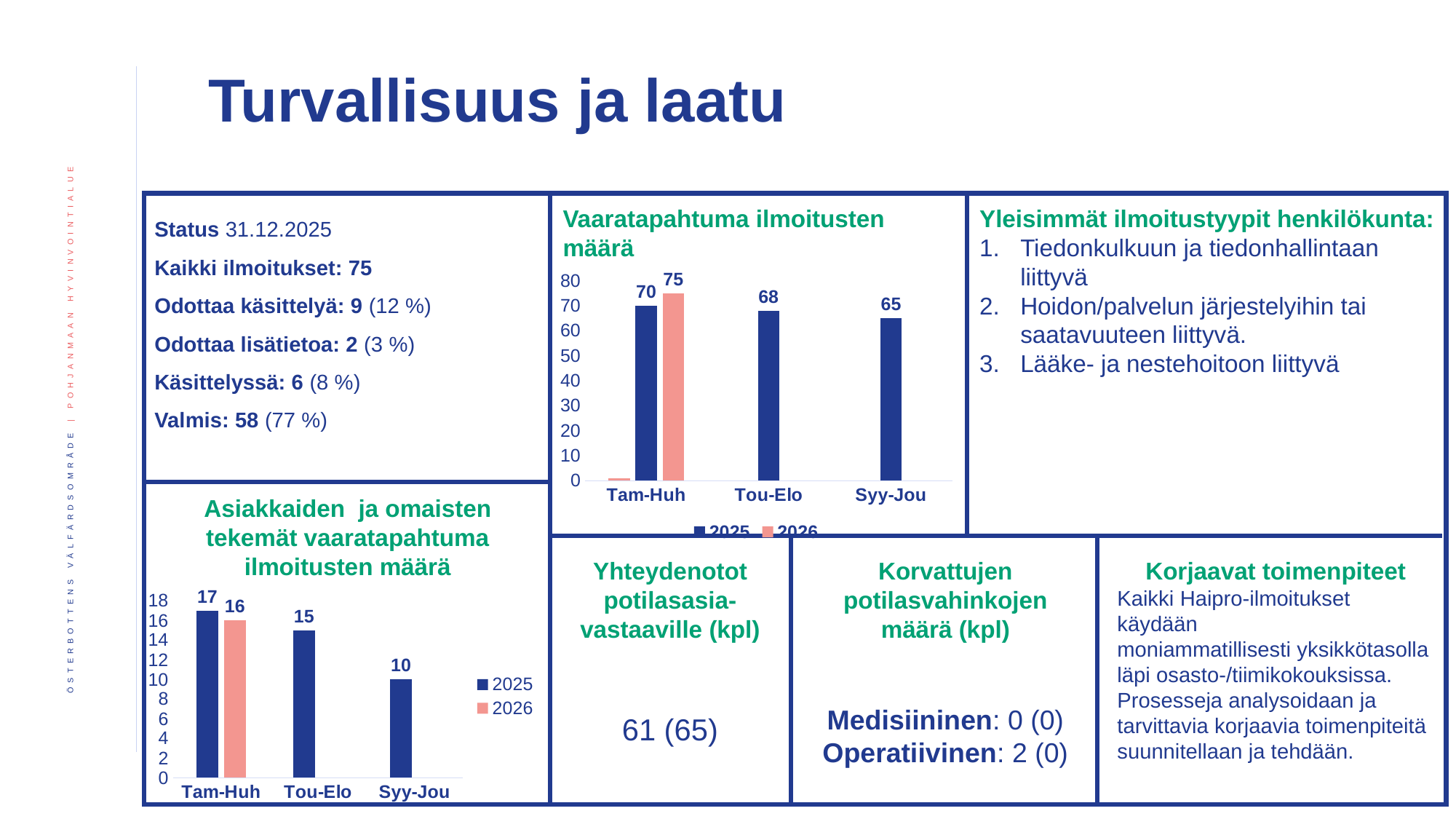
In the chart titled "Vaaratapahtuma ilmoitusten määrä", what is the 2025 value for Syy-Jou? 65 In the chart titled "Vaaratapahtuma ilmoitusten määrä", how many series does the legend list? 2 In the chart titled "Vaaratapahtuma ilmoitusten määrä", do the 2025 values rise or fall from Tam-Huh to Syy-Jou? fall In the chart titled "Vaaratapahtuma ilmoitusten määrä", what is the 2026 value for Tam-Huh? 75 In the chart titled "Asiakkaiden ja omaisten tekemät vaaratapahtuma ilmoitusten määrä", which period has the highest 2025 value? Tam-Huh In the chart titled "Vaaratapahtuma ilmoitusten määrä", which period has the lowest 2025 value? Syy-Jou In the chart titled "Asiakkaiden ja omaisten tekemät vaaratapahtuma ilmoitusten määrä", what is the 2025 value for Tou-Elo? 15 In the chart titled "Asiakkaiden ja omaisten tekemät vaaratapahtuma ilmoitusten määrä", what is the 2026 value for Tam-Huh? 16 In the chart titled "Asiakkaiden ja omaisten tekemät vaaratapahtuma ilmoitusten määrä", which is larger for Tam-Huh: the 2025 value or the 2026 value? 2025 What kind of chart is the chart titled "Asiakkaiden ja omaisten tekemät vaaratapahtuma ilmoitusten määrä"? bar chart In the chart titled "Vaaratapahtuma ilmoitusten määrä", what is the 2025 value for Tam-Huh? 70 In the chart titled "Vaaratapahtuma ilmoitusten määrä", what is the difference between the 2025 values for Tam-Huh and Tou-Elo? 2